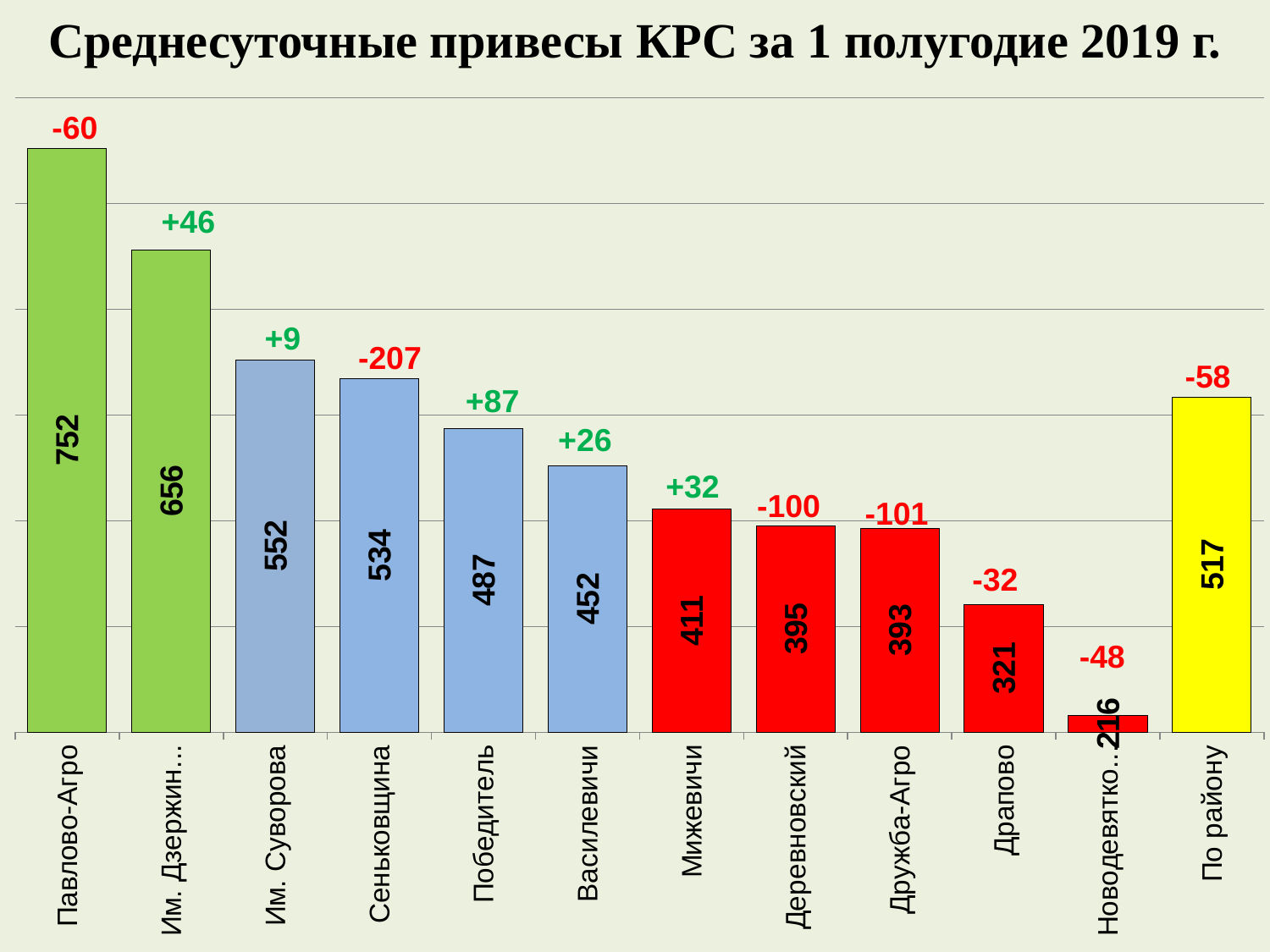
What type of chart is shown on the slide? bar chart What change figure is shown above the bar for Сеньковщина? -207 Which is larger, the value for Мижевичи or the value for Деревновский? Мижевичи What is the difference between the values for Победитель and Василевичи? 35 What is the value for Павлово-Агро? 752 How many bars are shown in the chart? 12 What is the value for По району? 517 What is the value for Драпово? 321 What is the value for Сеньковщина? 534 What change figure is shown above the bar for Победитель? +87 Which category has the highest value? Павлово-Агро What is the title of the chart? Среднесуточные привесы КРС за 1 полугодие 2019 г.